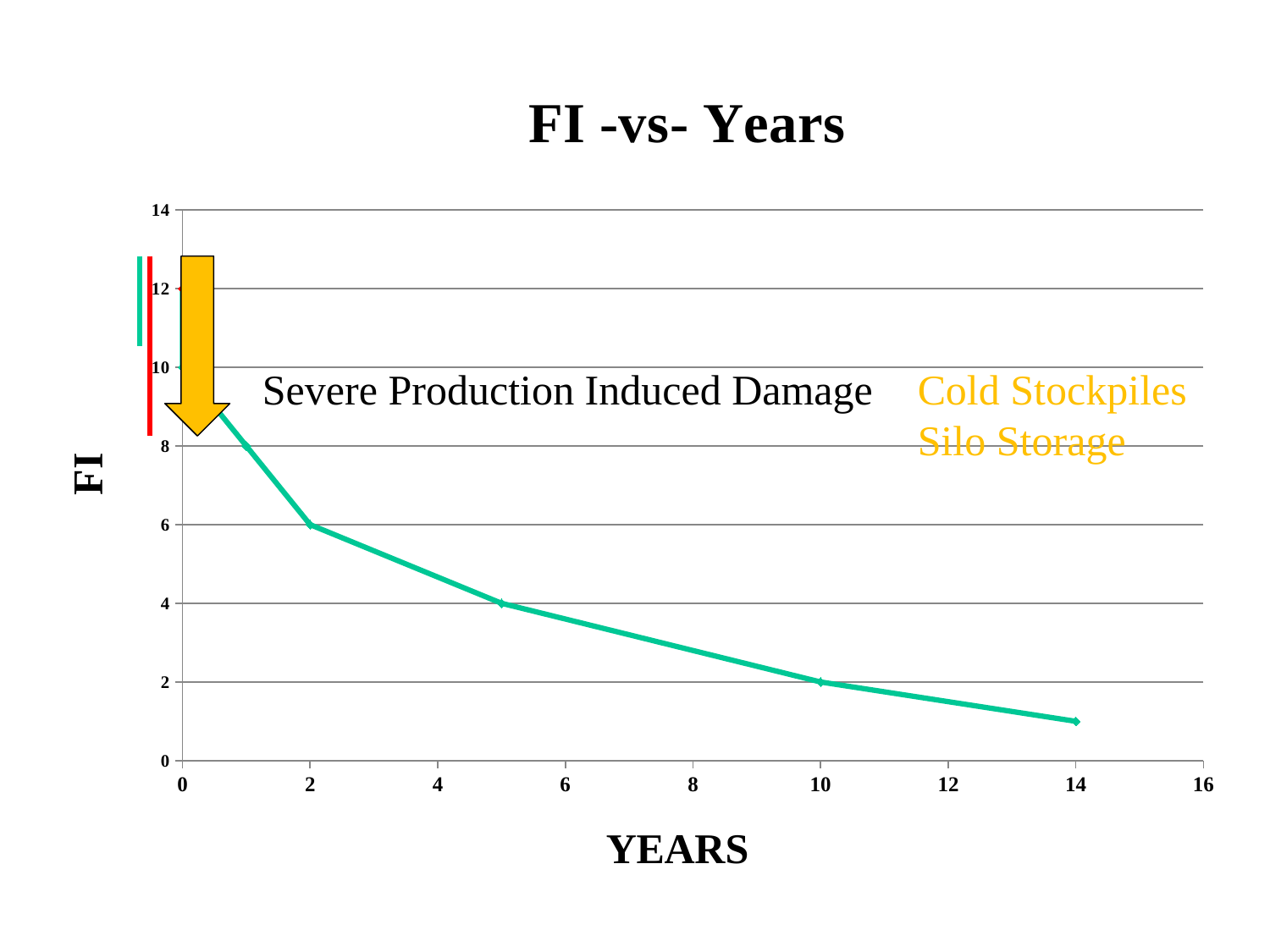
What is the difference between the FI value at 2 years and the FI value at 10 years? 4 At which plotted year is the FI value lowest? 14 What is the title of the chart? FI -vs- Years What is the FI value at 10 years? 2 Which is larger, the FI value at 2 years or at 10 years? 2 years What type of chart is shown on the slide? line chart Is the FI value at 14 years greater or less than 2? less What is the label of the x axis? YEARS Do the FI values rise or fall as the years increase? fall What is the FI value at 2 years? 6